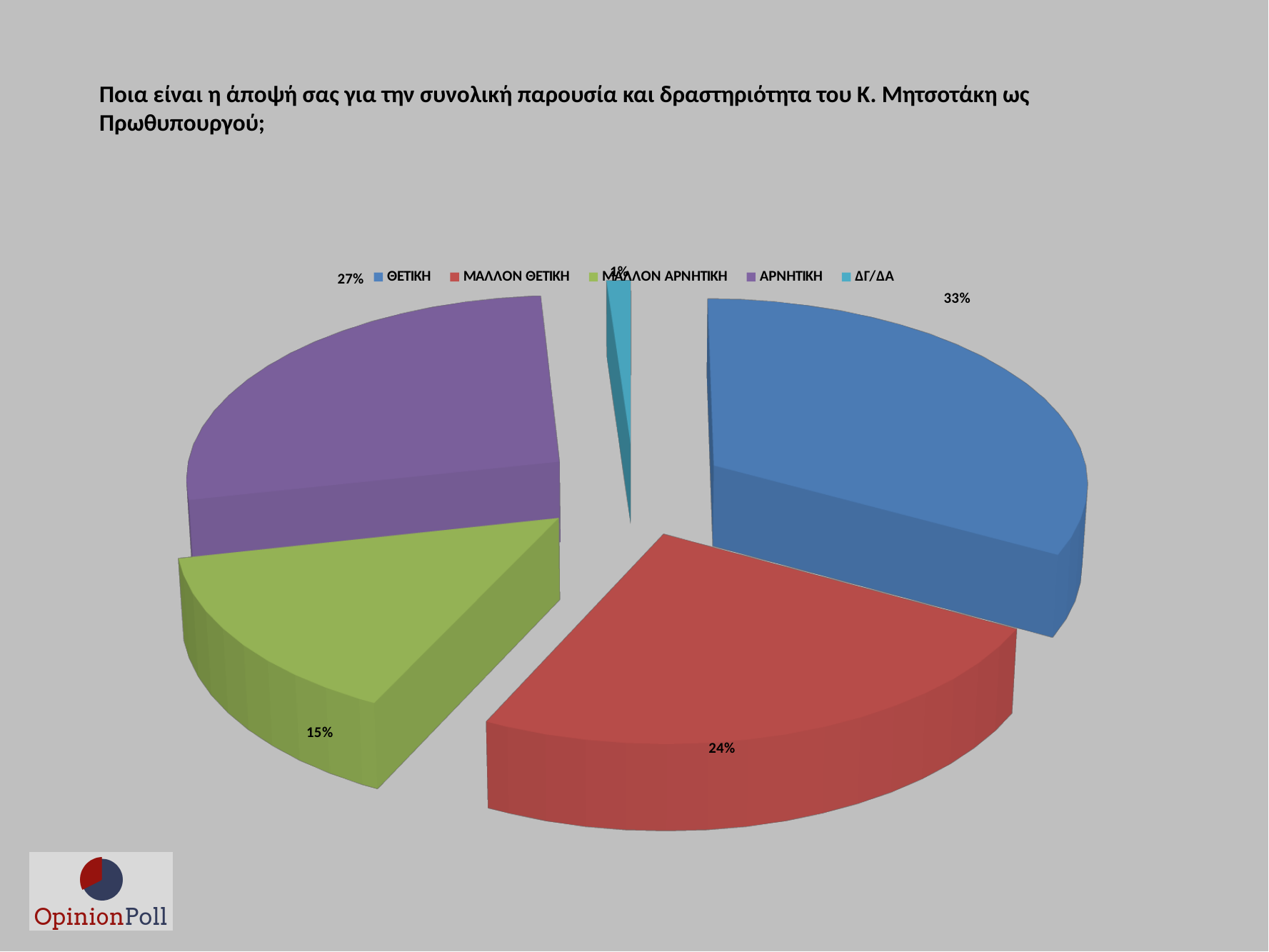
What percentage of the pie is ΔΓ/ΔΑ? 1% What percentage of the pie is ΜΑΛΛΟΝ ΑΡΝΗΤΙΚΗ? 15% What is the difference in percentage points between ΘΕΤΙΚΗ and ΑΡΝΗΤΙΚΗ? 6 Which category has the largest share of the pie? ΘΕΤΙΚΗ How many categories does the legend list? 5 What colour is the ΑΡΝΗΤΙΚΗ slice? Purple What kind of chart is shown on the slide? Pie chart What percentage of the pie is ΑΡΝΗΤΙΚΗ? 27% What percentage of the pie is ΜΑΛΛΟΝ ΘΕΤΙΚΗ? 24% Which category has the smallest share of the pie? ΔΓ/ΔΑ What percentage of the pie is ΘΕΤΙΚΗ? 33% Which is larger, ΜΑΛΛΟΝ ΘΕΤΙΚΗ or ΜΑΛΛΟΝ ΑΡΝΗΤΙΚΗ? ΜΑΛΛΟΝ ΘΕΤΙΚΗ